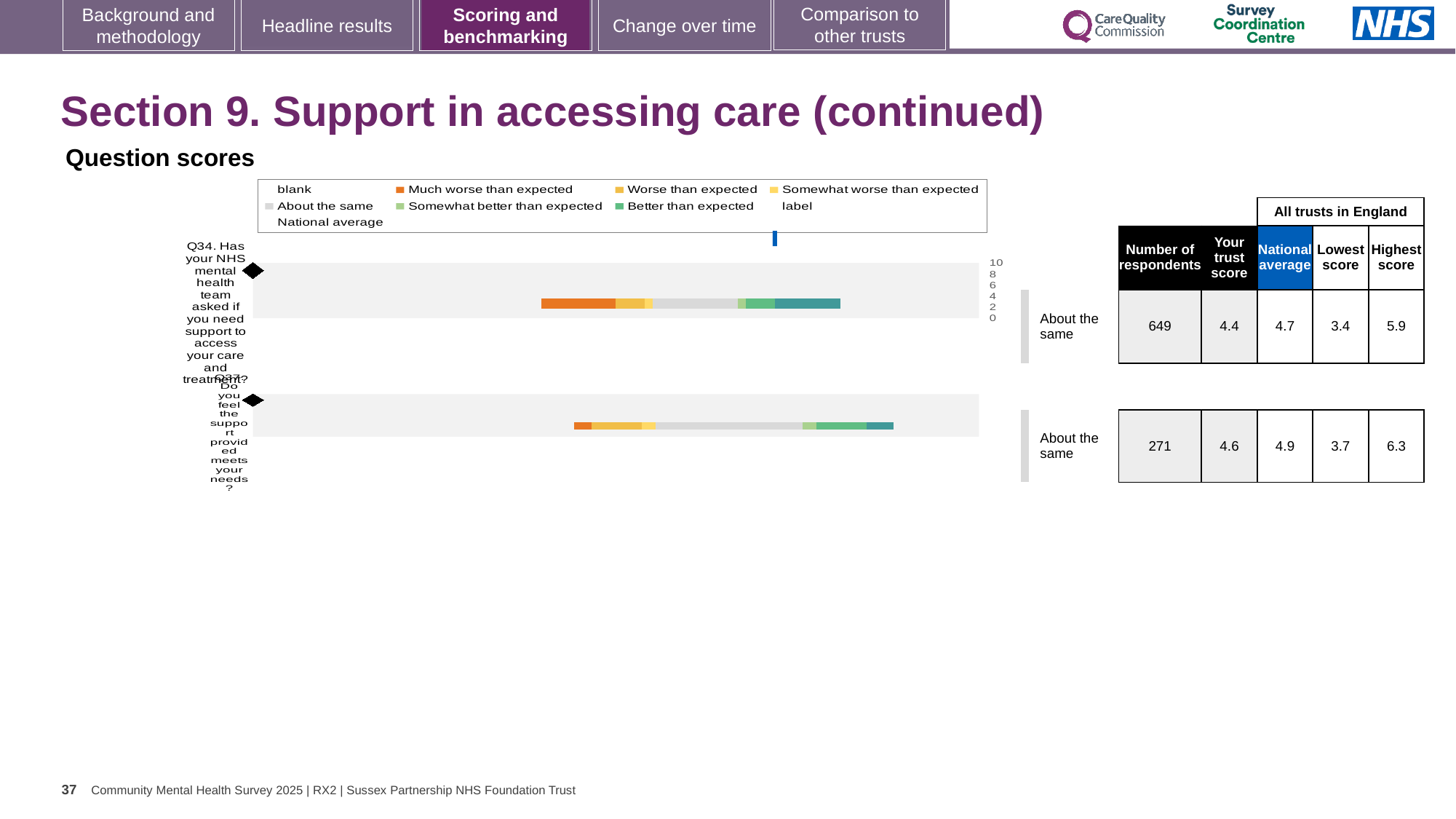
How many questions are plotted in the question scores chart? 2 In the table beside the chart, what is the lowest score across all trusts in England for Q34? 3.4 In the table beside the chart, what is the number of respondents for Q34? 649 What colour does the legend use for 'Much worse than expected'? orange What is the difference between the national average and the trust score for Q37 in the table? 0.3 What is the difference between the highest score and the lowest score for Q34 in the table? 2.5 What kind of chart is used to show the question scores on this slide? bar chart In the table beside the chart, what is the national average for Q37? 4.9 In the table beside the chart, what is the trust score for Q34? 4.4 Which benchmark category is shown for Q34 in the question scores chart? About the same Which question has the higher trust score in the table, Q34 or Q37? Q37 In the table beside the chart, what is the highest score across all trusts in England for Q37? 6.3